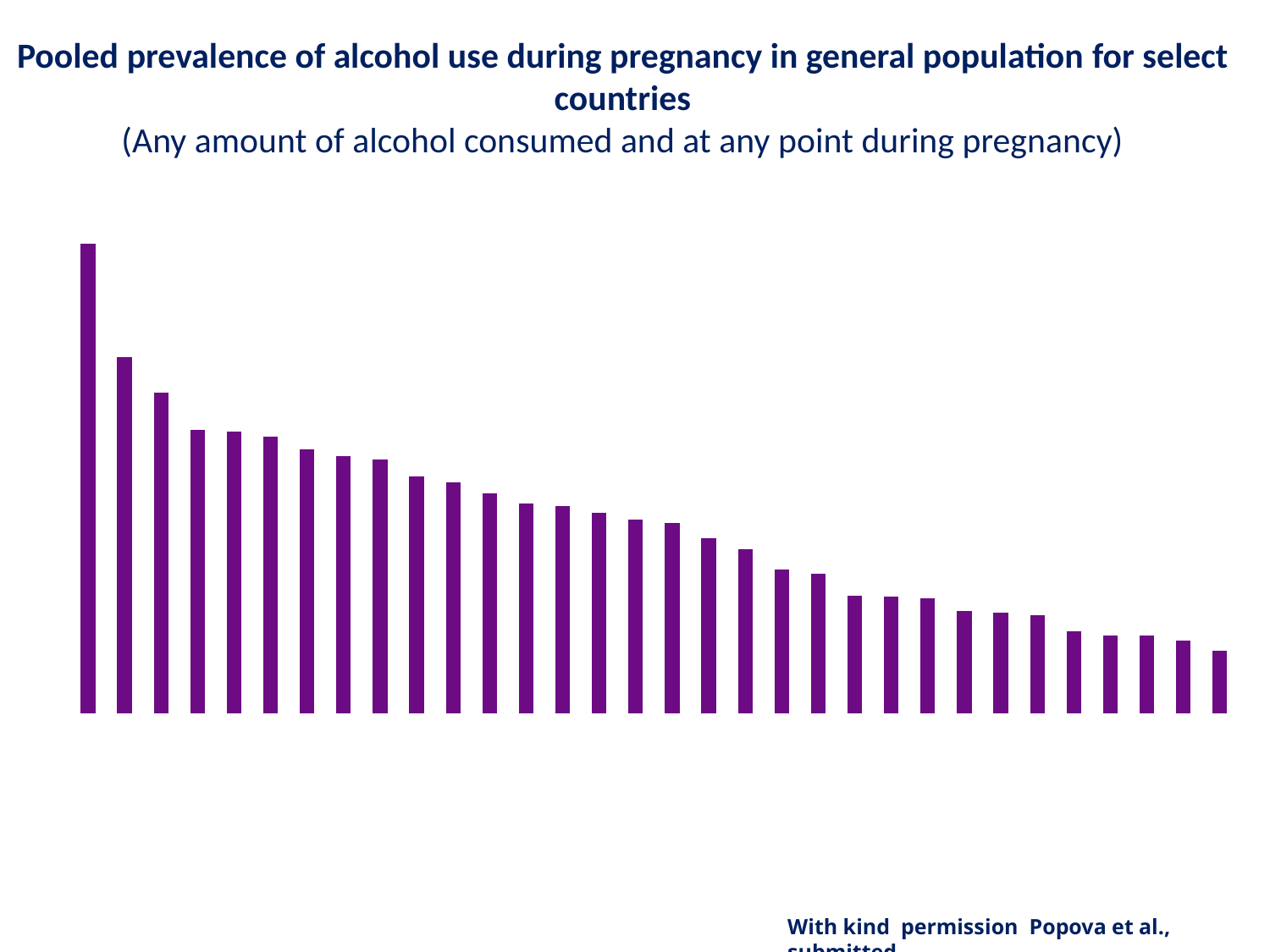
Do the bar values rise or fall from left to right across the chart? fall Which bar is the shortest in the chart, the leftmost or the rightmost? rightmost What is the title of the chart on the slide? Pooled prevalence of alcohol use during pregnancy in general population for select countries Is the rightmost bar taller or shorter than the bar immediately to its left? shorter How many bars are plotted in the chart? 32 What kind of chart is shown on the slide? bar chart Is the leftmost bar taller or shorter than the second bar from the left? taller What colour are the bars in the chart? purple Which bar is the tallest in the chart, the leftmost or the rightmost? leftmost